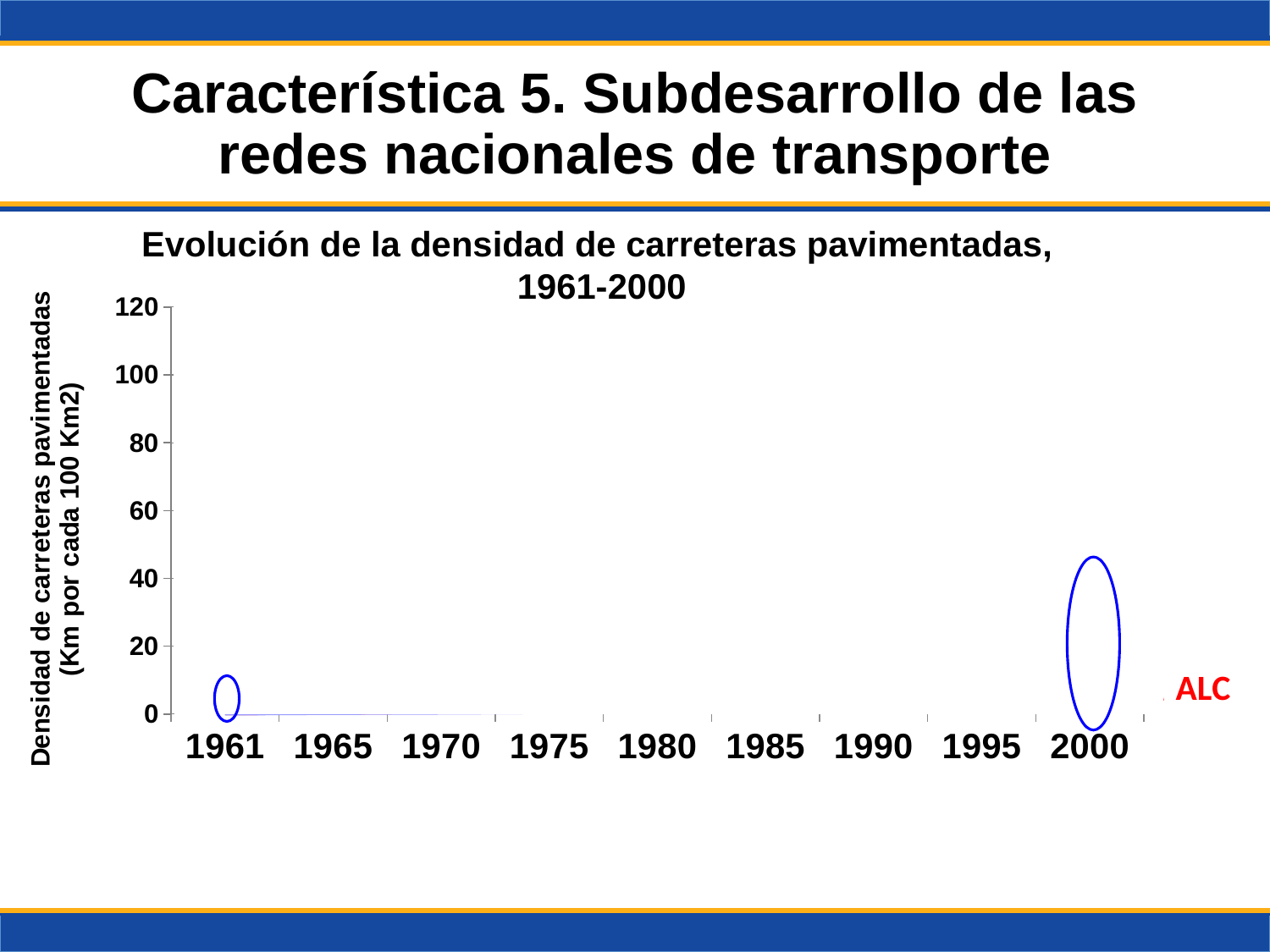
Is the value for ALC in 1965 greater or less than 40? less What label is shown in red next to the plotted series? ALC What is the title of the chart? Evolución de la densidad de carreteras pavimentadas, 1961-2000 Is the value for ALC in 1961 greater or less than 20? less What kind of chart is shown on the slide? line chart How many year labels are shown along the x axis? 9